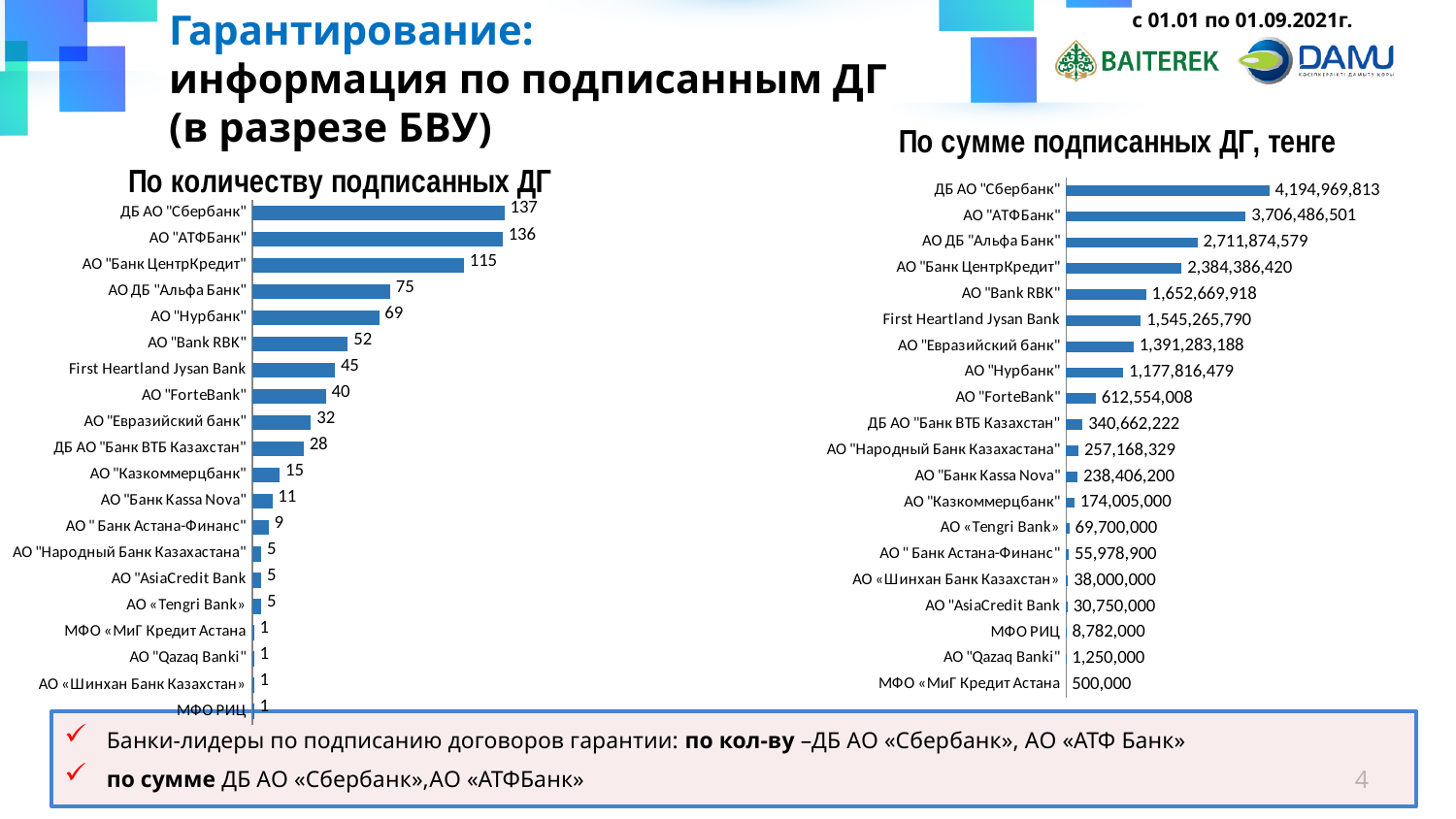
In the chart "По количеству подписанных ДГ", how many banks are listed? 20 What type of chart is "По количеству подписанных ДГ"? Bar chart In the chart "По сумме подписанных ДГ, тенге", which is larger: АО "Нурбанк" or АО "ForteBank"? АО "Нурбанк" In the chart "По количеству подписанных ДГ", what is the value for АО "Банк ЦентрКредит"? 115 In the chart "По сумме подписанных ДГ, тенге", what is the difference between ДБ АО "Сбербанк" and АО "АТФБанк"? 488,483,312 In the chart "По количеству подписанных ДГ", which bank has the highest value? ДБ АО "Сбербанк" In the chart "По количеству подписанных ДГ", what is the value for АО "Нурбанк"? 69 In the chart "По сумме подписанных ДГ, тенге", what is the value for АО «Tengri Bank»? 69,700,000 In the chart "По сумме подписанных ДГ, тенге", what is the value for АО "Bank RBK"? 1,652,669,918 In the chart "По количеству подписанных ДГ", what is the difference between ДБ АО "Сбербанк" and АО "АТФБанк"? 1 In the chart "По количеству подписанных ДГ", which is larger: АО "Евразийский банк" or ДБ АО "Банк ВТБ Казахстан"? АО "Евразийский банк" In the chart "По сумме подписанных ДГ, тенге", which bank has the lowest value? МФО «МиГ Кредит Астана